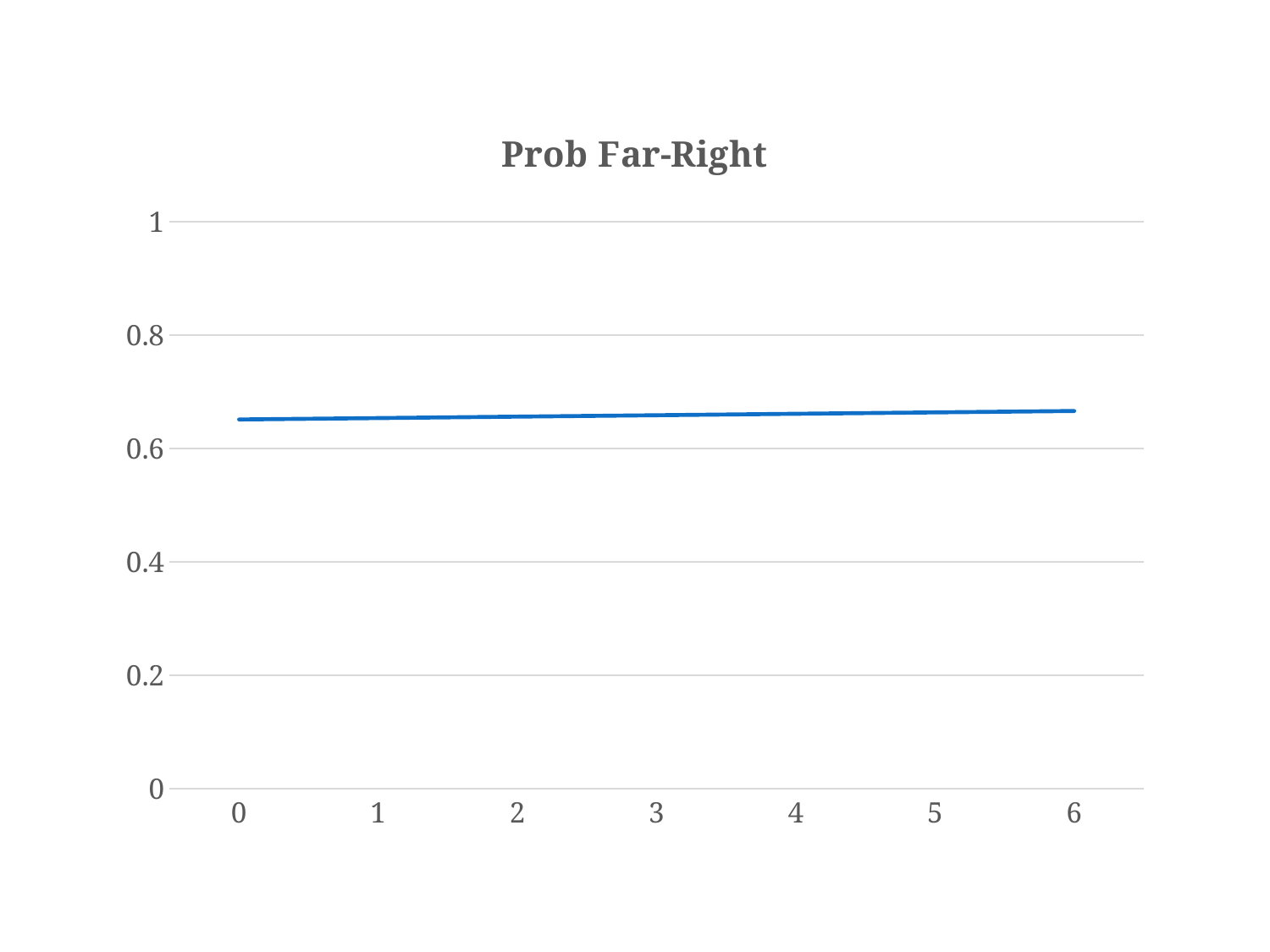
Is the value at x = 0 greater or less than 0.6? greater What is the title of the chart? Prob Far-Right How many tick labels are shown on the x axis? 7 What is the highest value shown on the y axis? 1 Is the value at x = 6 greater or less than 0.8? less Do the values rise or fall as x goes from 0 to 6? rise Is the value at x = 6 greater or less than 0.6? greater What kind of chart is shown on the slide? line chart